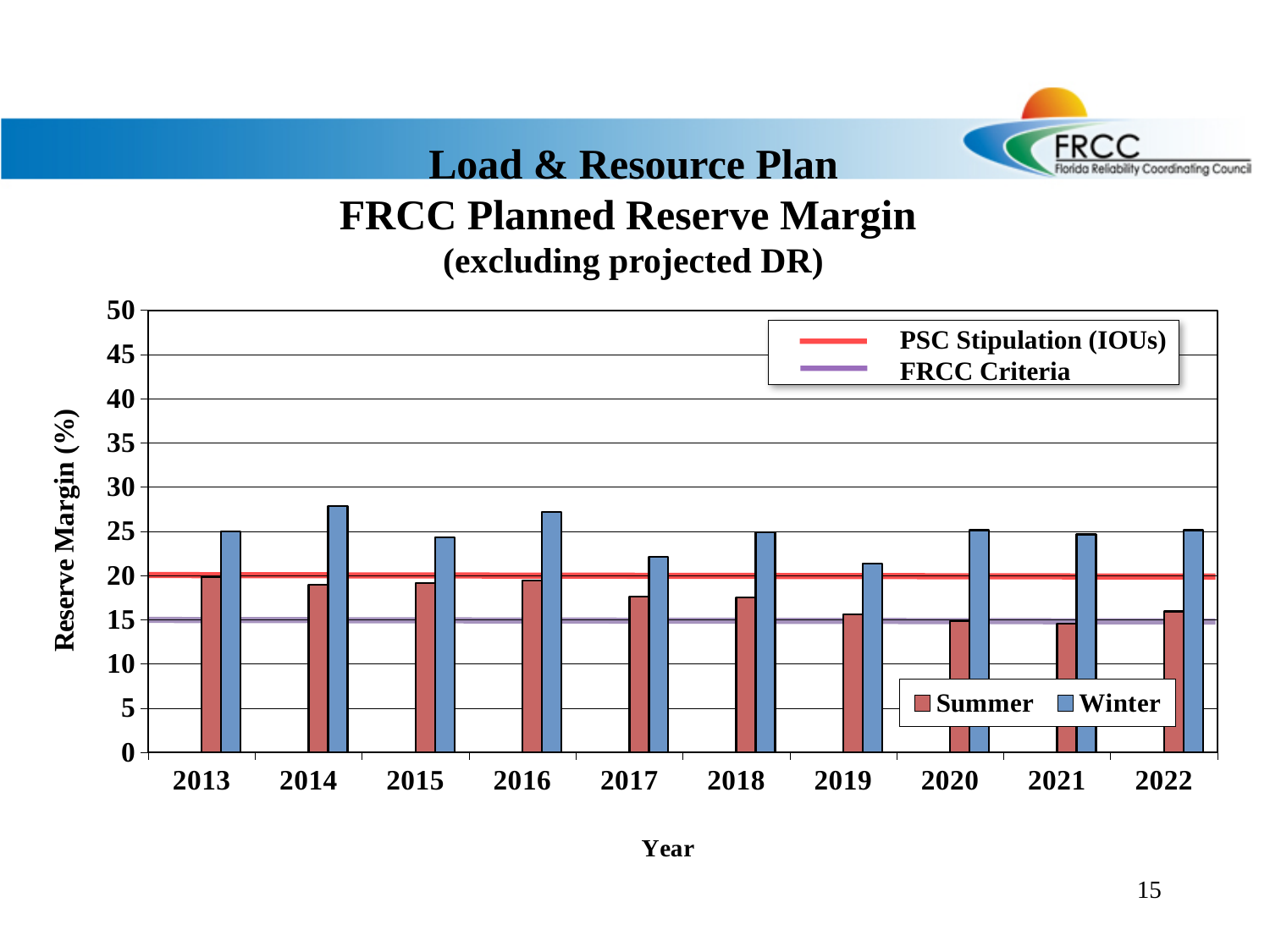
Is the Summer value for 2017 greater or less than 20? less Which is larger in 2016, the Summer value or the Winter value? Winter What kind of chart is shown on the slide? bar chart Is the Winter value for 2017 greater or less than 20? greater How many years are shown on the x axis of the chart? 10 At what reserve margin value is the FRCC Criteria line drawn? 15 Which is larger, the Summer value for 2013 or the Summer value for 2021? 2013 How many series does the Summer/Winter legend list? 2 Is the Winter value for 2019 greater or less than 25? less At what reserve margin value is the PSC Stipulation (IOUs) line drawn? 20 Do the Summer values generally rise or fall from 2013 to 2021? fall